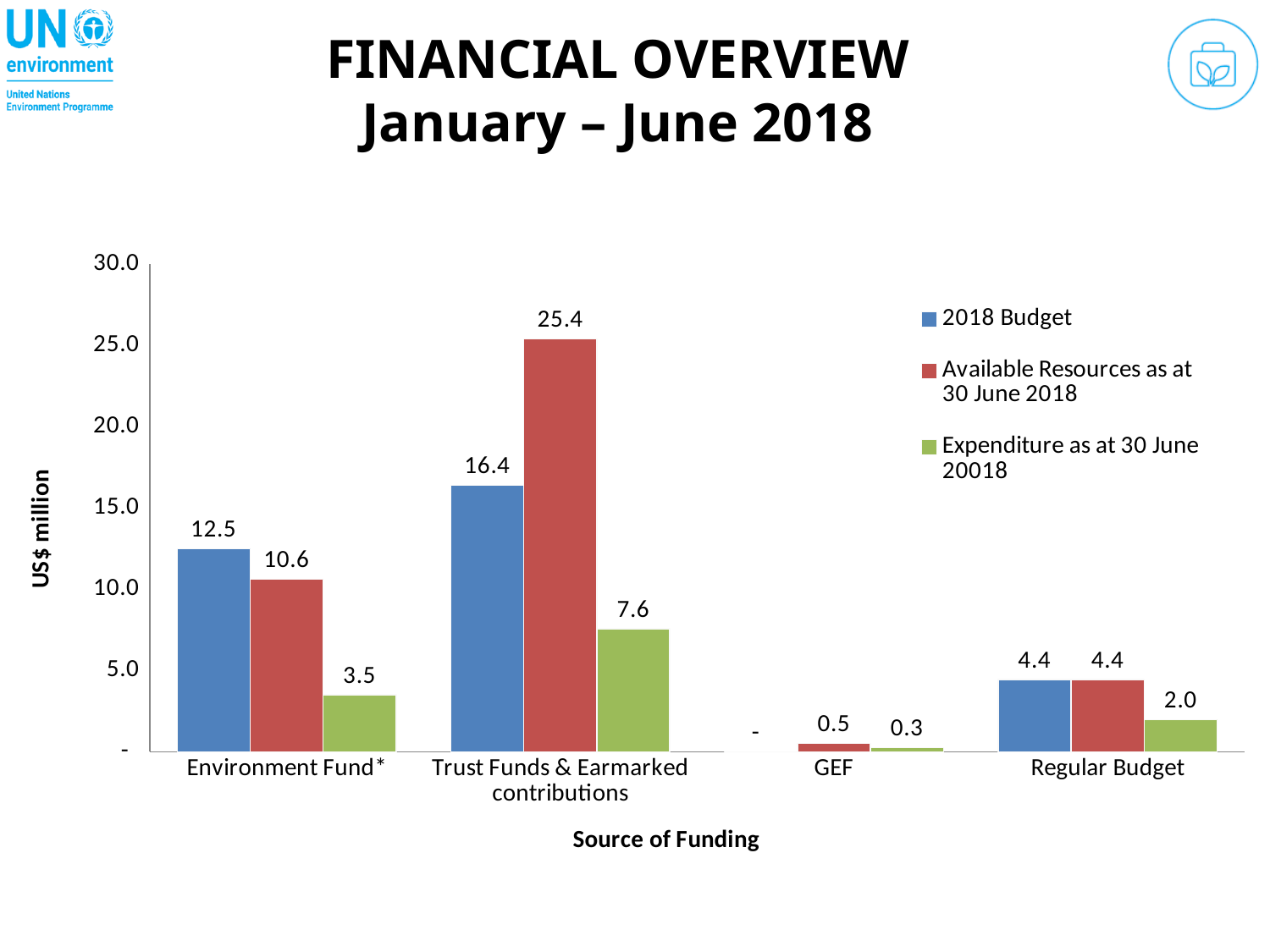
For Environment Fund*, which is larger: the 2018 Budget or the Available Resources as at 30 June 2018? 2018 Budget How many sources of funding are shown on the x axis? 4 For Regular Budget, what is the difference between the 2018 Budget and Expenditure as at 30 June? 2.4 What is the Expenditure as at 30 June value for Regular Budget? 2.0 Is the Available Resources value for Trust Funds & Earmarked contributions greater or less than 20.0? greater Which source of funding has the lowest Expenditure as at 30 June? GEF Which source of funding has the highest Available Resources as at 30 June 2018? Trust Funds & Earmarked contributions What is the title of the vertical axis? US$ million What is the 2018 Budget value for Environment Fund*? 12.5 For Trust Funds & Earmarked contributions, what is the difference between Available Resources as at 30 June 2018 and the 2018 Budget? 9.0 What is the Available Resources as at 30 June 2018 value for Trust Funds & Earmarked contributions? 25.4 How many series does the legend list? 3